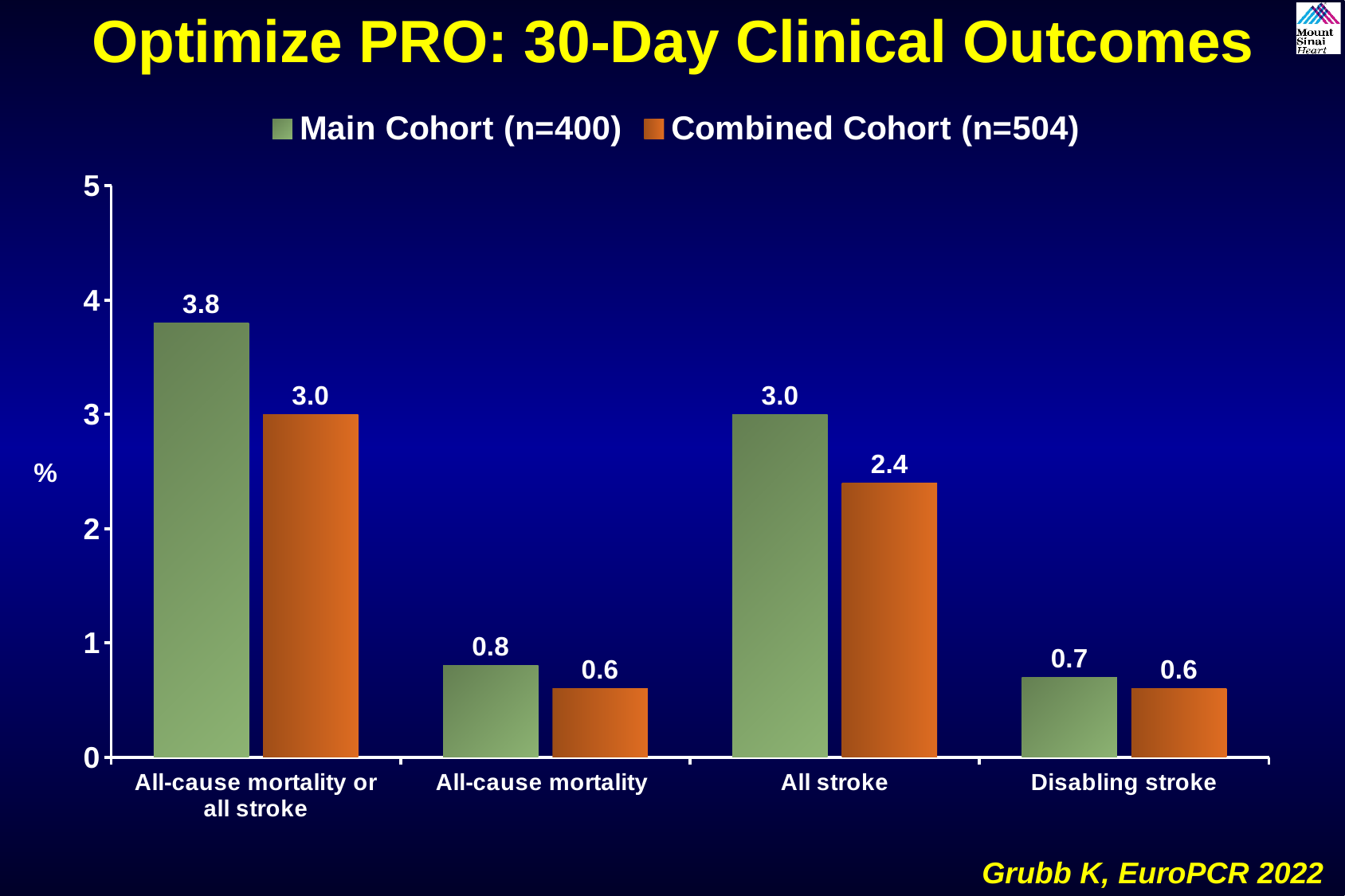
How many categories are shown on the x axis? 4 How many series does the legend list? 2 What kind of chart is shown on the slide? Bar chart What is the difference between the Main Cohort (n=400) and Combined Cohort (n=504) values for All stroke? 0.6 What is the value for the Main Cohort (n=400) for All-cause mortality or all stroke? 3.8 What is the value for the Combined Cohort (n=504) for All-cause mortality? 0.6 What is the value for the Main Cohort (n=400) for Disabling stroke? 0.7 Which is larger for All stroke: the Main Cohort (n=400) or the Combined Cohort (n=504)? Main Cohort (n=400) Which category has the highest value for the Main Cohort (n=400)? All-cause mortality or all stroke What is the value for the Combined Cohort (n=504) for All stroke? 2.4 Which category has the lowest value for the Main Cohort (n=400)? Disabling stroke What is the difference between the Main Cohort (n=400) and Combined Cohort (n=504) values for All-cause mortality or all stroke? 0.8